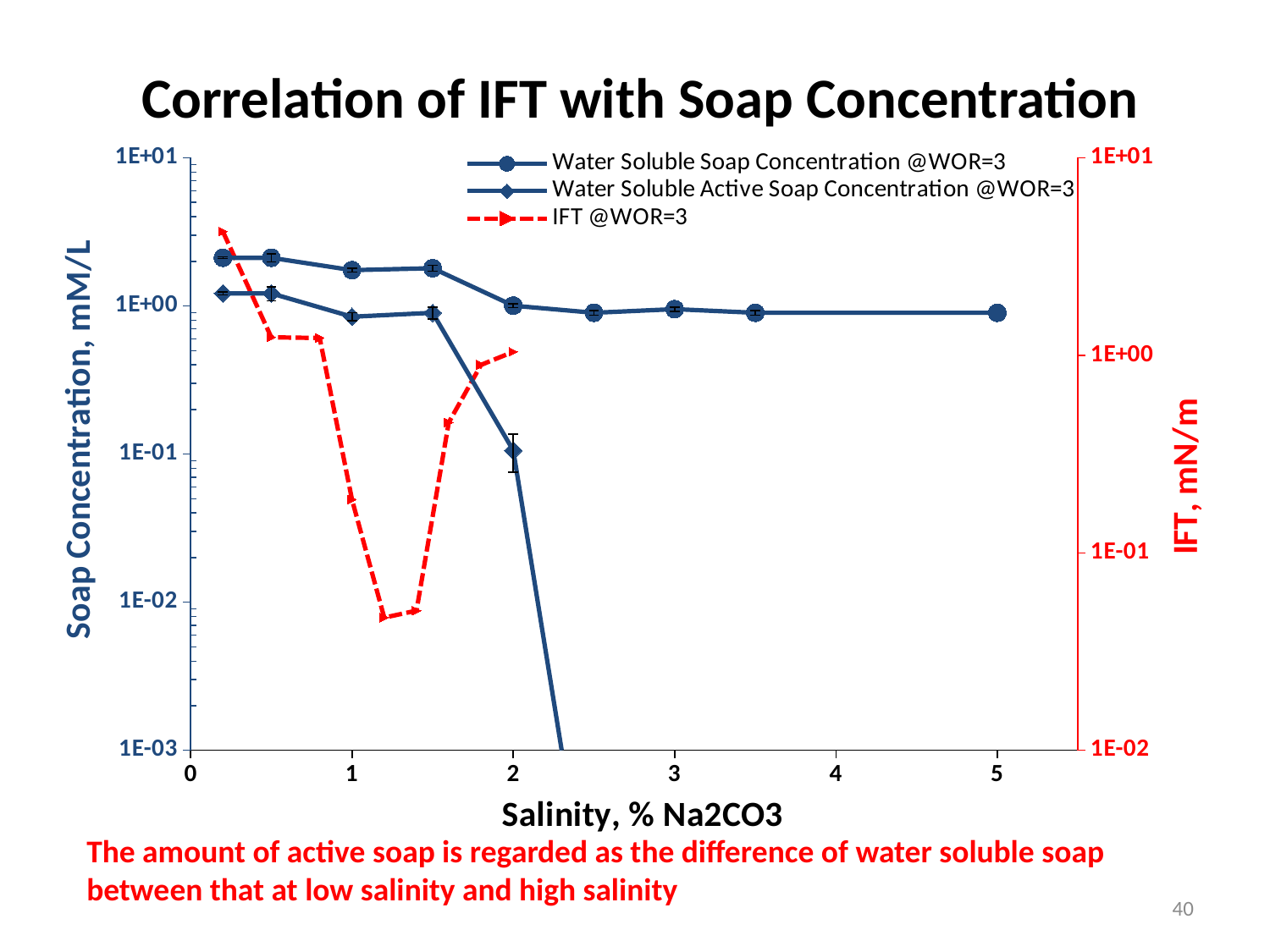
Does the Water Soluble Soap Concentration @WOR=3 generally rise or fall as salinity increases from 0.2 to 5? fall How many data points are plotted for the Water Soluble Soap Concentration @WOR=3 series? 9 Is the lowest IFT @WOR=3 value greater or less than 1E-01 mN/m? less Is the Water Soluble Soap Concentration @WOR=3 value at salinity 0.2 greater or less than 1E+00 mM/L? greater At salinity 1, which is larger: the Water Soluble Soap Concentration @WOR=3 or the Water Soluble Active Soap Concentration @WOR=3? Water Soluble Soap Concentration @WOR=3 What is the label of the right-hand vertical axis? IFT, mN/m Is the Water Soluble Active Soap Concentration @WOR=3 value at salinity 1 greater or less than 1E-01 mM/L? greater Does the Water Soluble Active Soap Concentration @WOR=3 rise or fall as salinity increases from 0.2 to 2? fall What kind of chart is shown on the slide? line chart What is the title of the chart? Correlation of IFT with Soap Concentration How many series does the legend list? 3